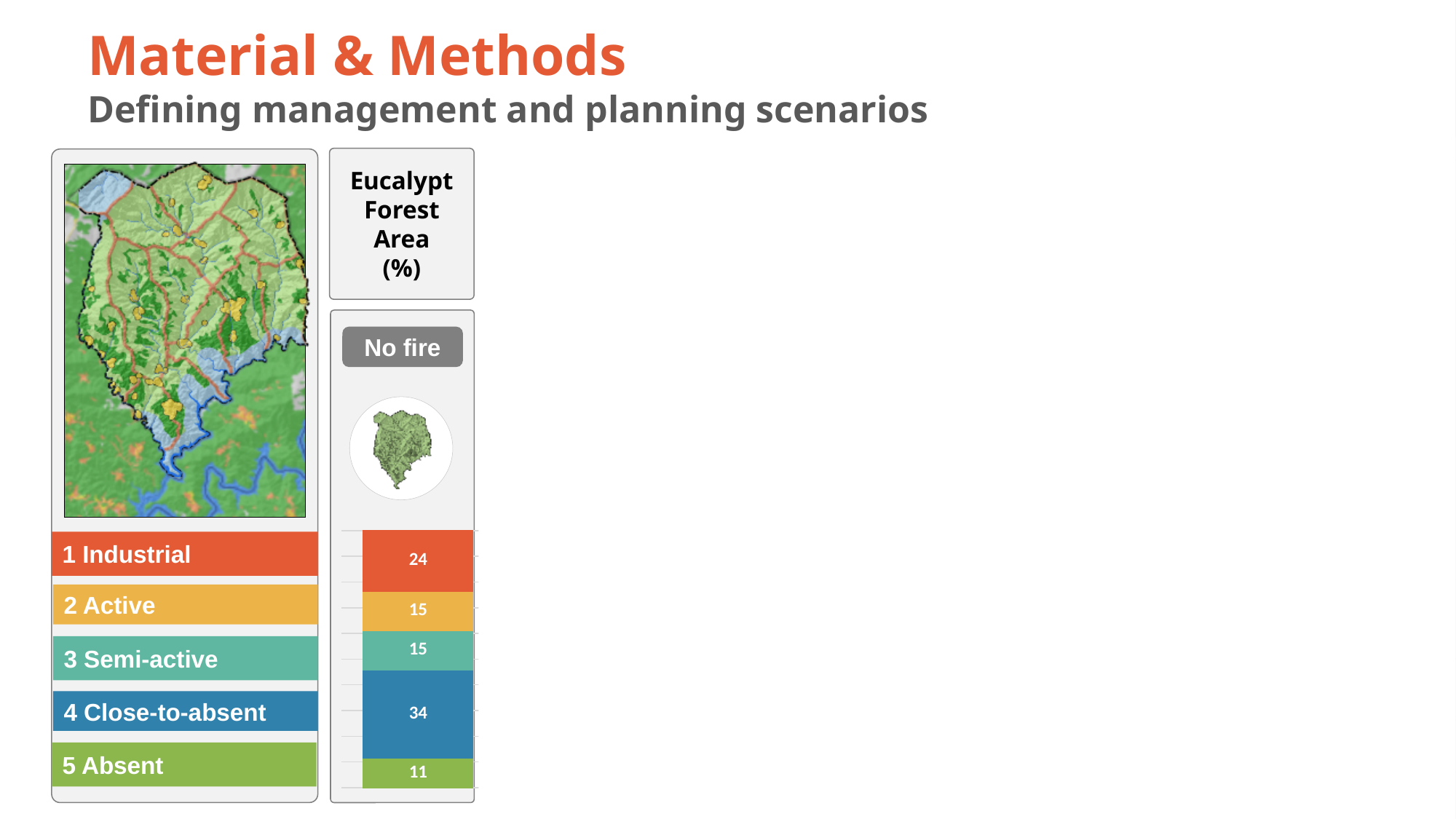
How many management categories are shown in the No fire stacked bar? 5 In the No fire bar, is the value for Industrial larger or smaller than the value for Absent? larger In the No fire bar, what is the difference between the Close-to-absent value and the Industrial value? 10 Which management category has the smallest share of Eucalypt Forest Area in the No fire bar? 5 Absent In the No fire stacked bar, what is the value for the Absent category? 11 What colour is the segment for the Semi-active category in the No fire bar? teal Which management category has the largest share of Eucalypt Forest Area in the No fire bar? 4 Close-to-absent What type of chart is used to show the Eucalypt Forest Area (%) under No fire? stacked bar chart What is the total of all segments in the No fire stacked bar? 99 In the No fire stacked bar, what is the Eucalypt Forest Area (%) value for the Industrial management category? 24 In the No fire stacked bar, what is the value for the Active category? 15 In the No fire stacked bar, what is the value for the Close-to-absent category? 34